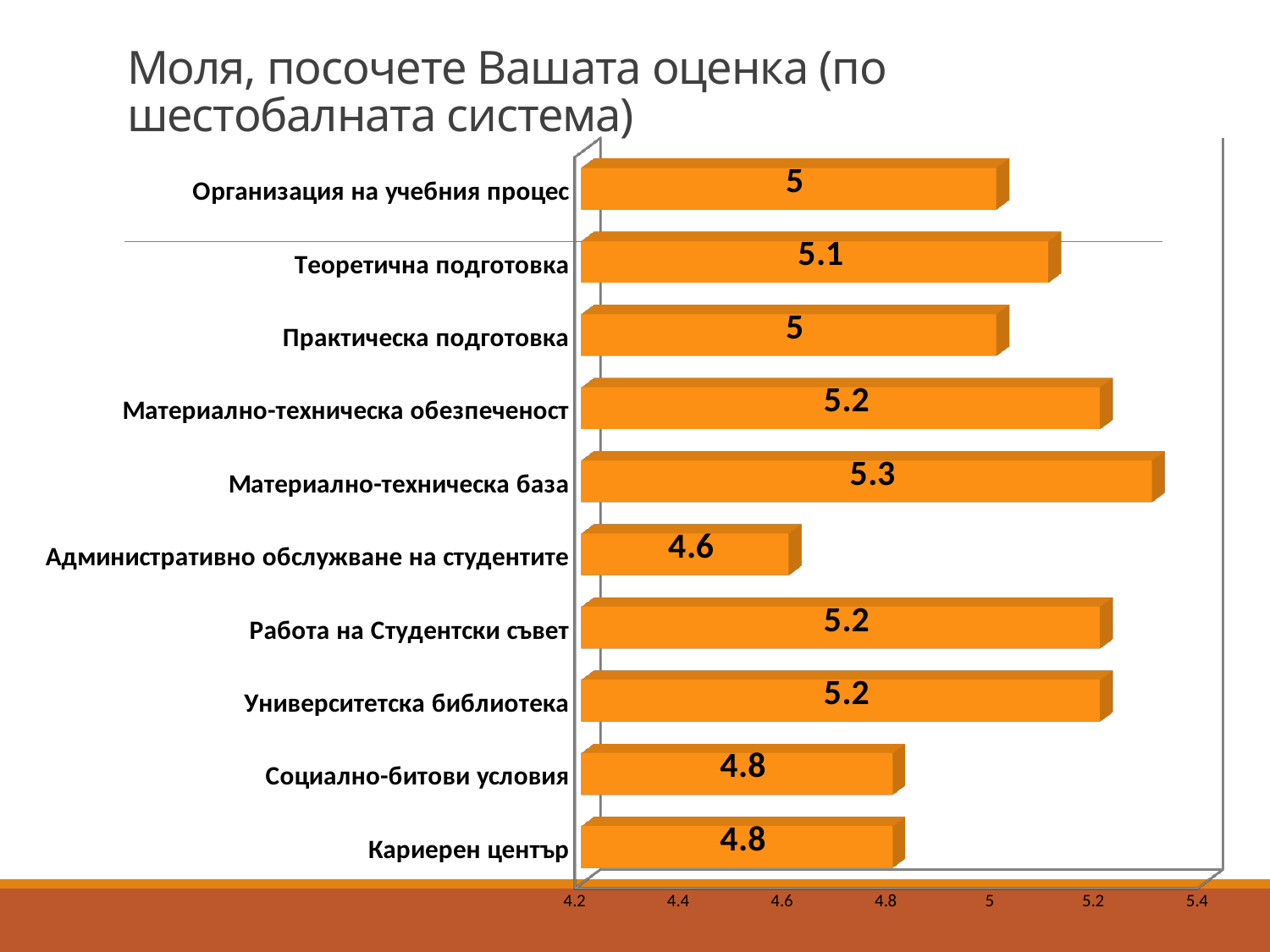
Which is larger, the value for Теоретична подготовка or the value for Социално-битови условия? Теоретична подготовка What is the value for Кариерен център? 4.8 What kind of chart is shown on the slide? Bar chart How many categories are shown in the chart? 10 What is the difference between the values for Университетска библиотека and Кариерен център? 0.4 What is the difference between the values for Материално-техническа база and Административно обслужване на студентите? 0.7 Which category has the lowest value? Административно обслужване на студентите What colour are the bars in the chart? Orange What is the value for Теоретична подготовка? 5.1 What is the value for Материално-техническа база? 5.3 What is the value for Административно обслужване на студентите? 4.6 Which category has the highest value? Материално-техническа база